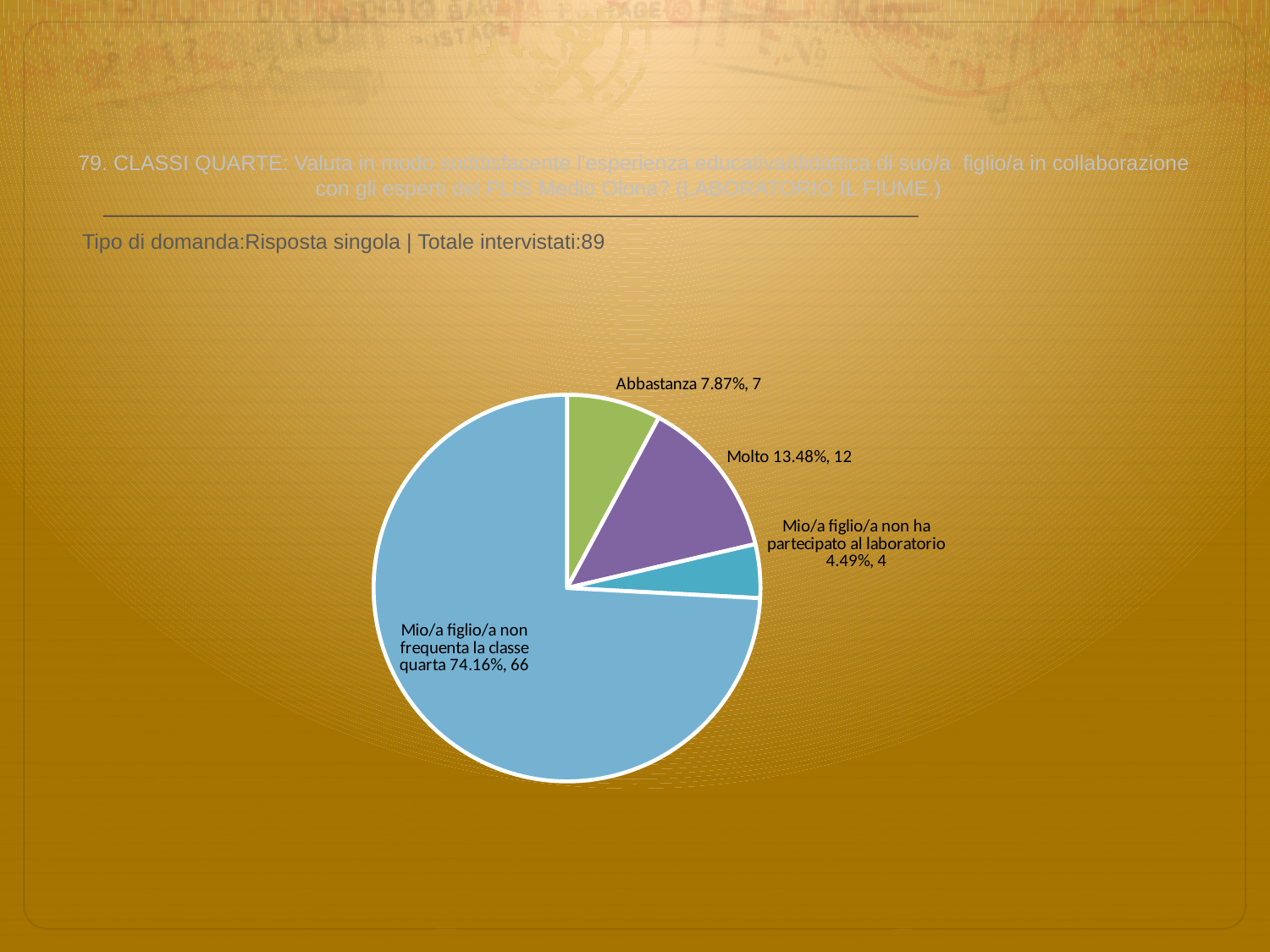
What kind of chart is shown on the slide? pie chart What percentage share does the 'Mio/a figlio/a non ha partecipato al laboratorio' slice have? 4.49% What is the difference in respondent count between 'Molto' and 'Abbastanza'? 5 What is the total number of respondents across all slices? 89 Which slice is the largest? Mio/a figlio/a non frequenta la classe quarta How many respondents answered 'Abbastanza'? 7 Which slice is the smallest? Mio/a figlio/a non ha partecipato al laboratorio What colour is the 'Molto' slice? purple What percentage share does the 'Molto' slice have? 13.48% How many slices does the pie chart have? 4 Which has more respondents, 'Molto' or 'Abbastanza'? Molto What is the count for 'Mio/a figlio/a non frequenta la classe quarta'? 66